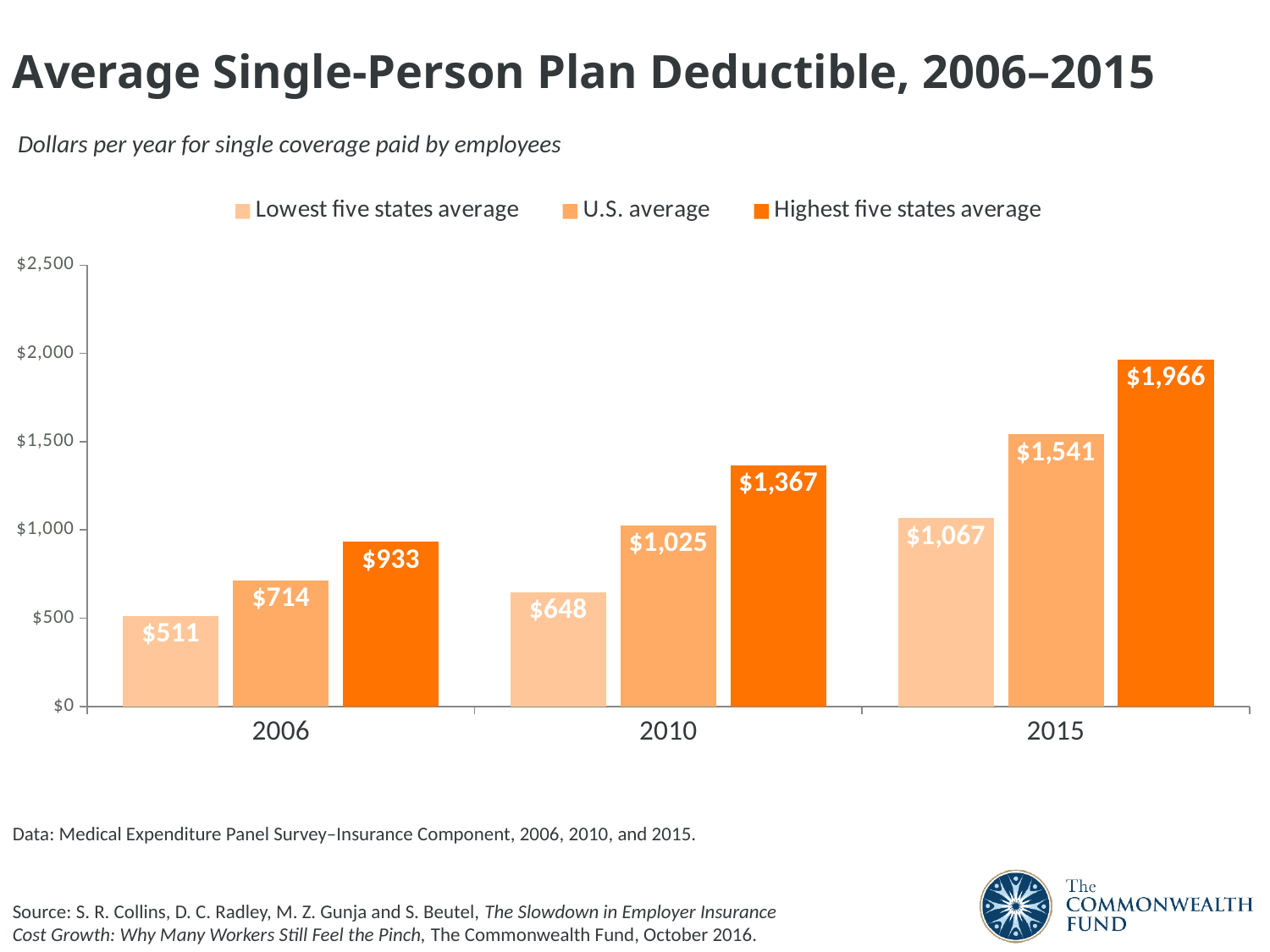
What is the lowest five states average deductible in 2006? $511 Which series has the lowest value in 2010? Lowest five states average What is the U.S. average single-person plan deductible in 2010? $1,025 What kind of chart is shown on the slide? Bar chart In which year is the U.S. average deductible highest? 2015 Which is larger: the U.S. average in 2006 or the lowest five states average in 2010? U.S. average in 2006 How many years are shown on the x axis? 3 What is the highest five states average deductible in 2015? $1,966 How many series does the legend list? 3 Does the U.S. average deductible rise or fall from 2006 to 2015? Rise What is the difference between the highest five states average and the lowest five states average in 2015? $899 Is the highest five states average in 2006 greater or less than $1,000? less